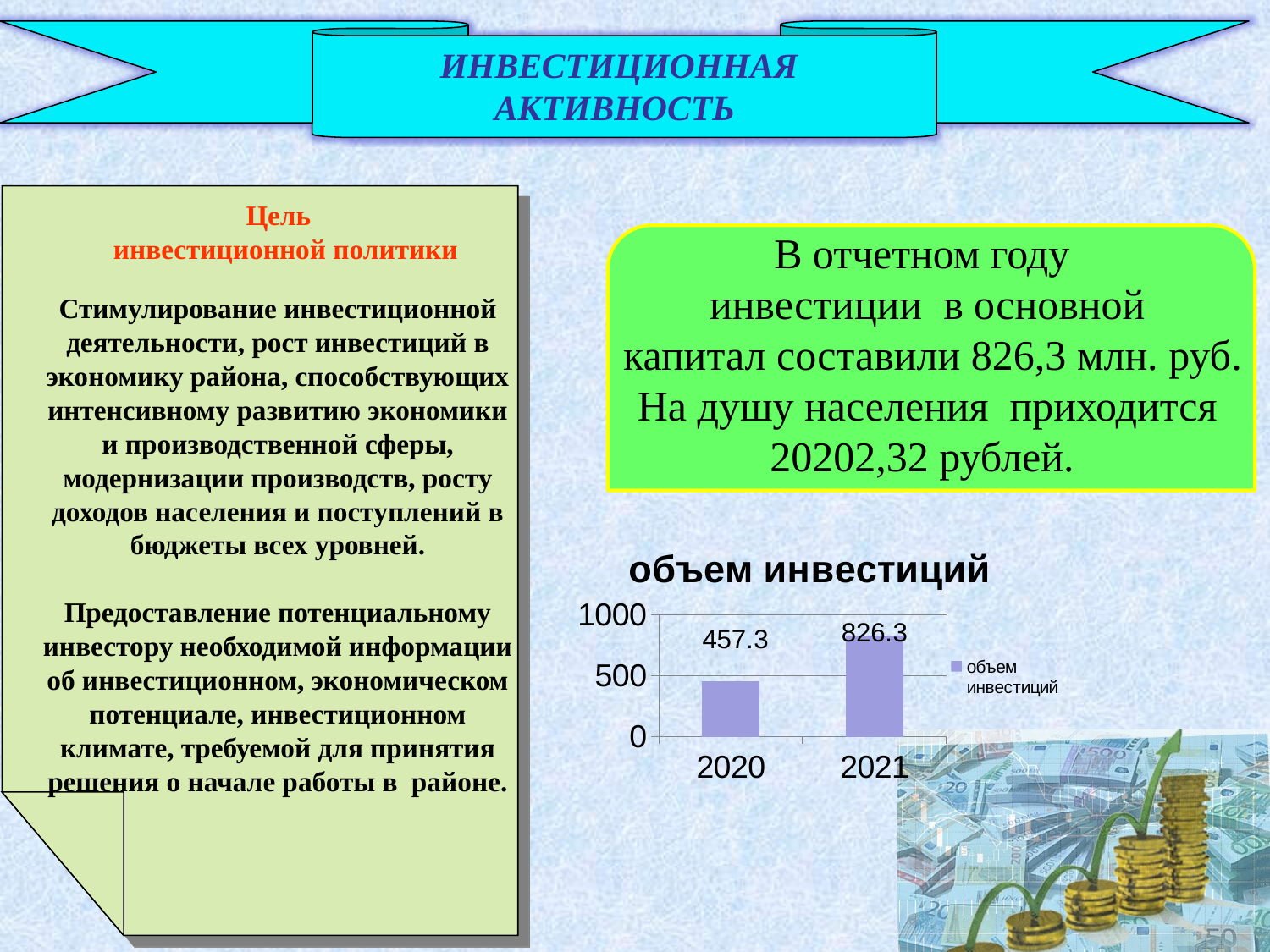
Is the value for 2021 greater or less than 500? greater What is the value for 2020 in the chart? 457.3 How many series does the chart legend list? 1 Is the value for 2020 greater or less than 500? less Which is larger, the value for 2020 or the value for 2021? 2021 What is the title of the chart? объем инвестиций What is the difference between the values for 2021 and 2020? 369.0 Which year has the highest value in the chart? 2021 What is the value for 2021 in the chart? 826.3 What kind of chart is shown on the slide? bar chart Which year has the lowest value in the chart? 2020 How many categories are shown on the x axis of the chart? 2